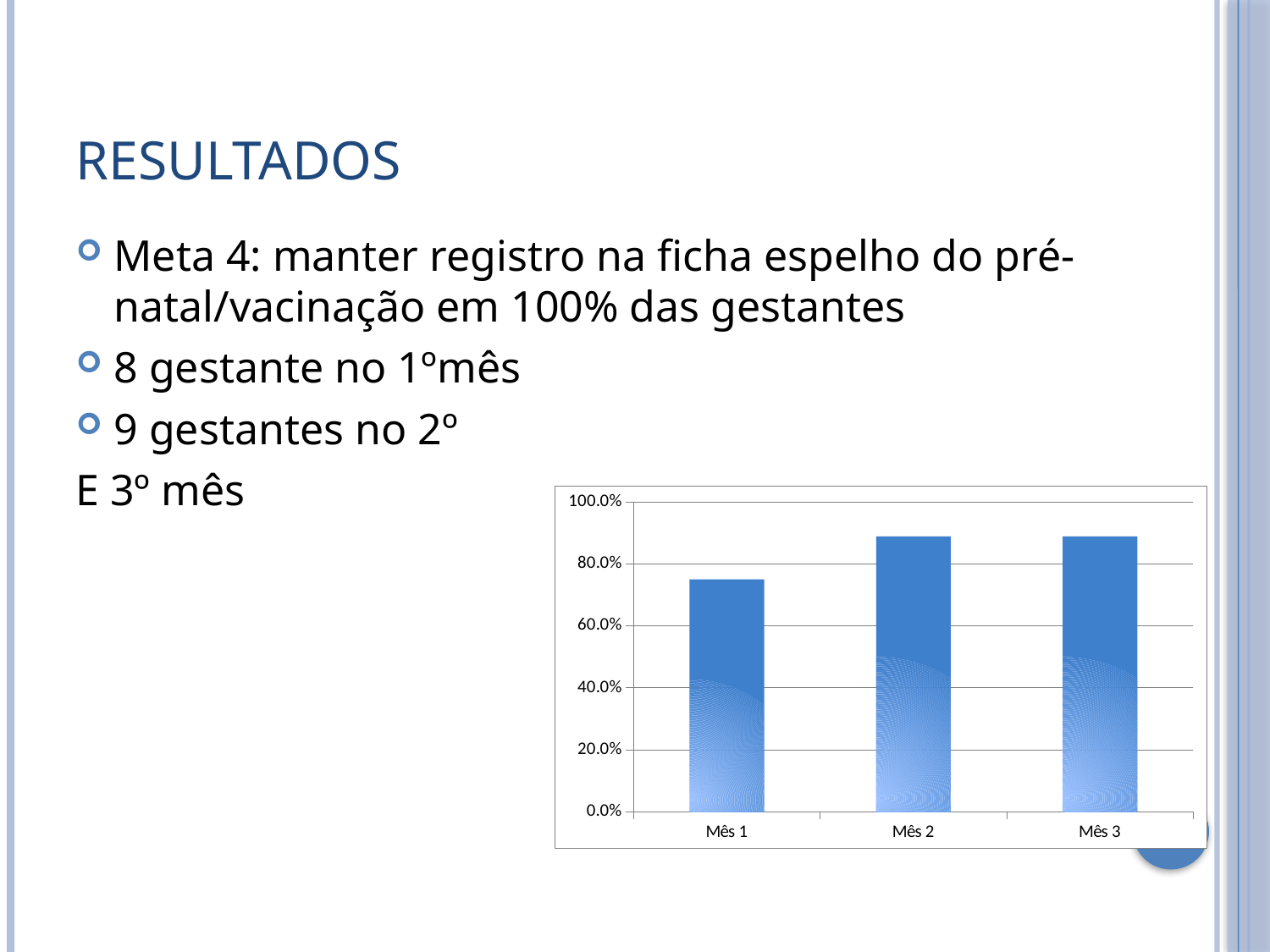
Which category has the lowest bar in the chart? Mês 1 Is the value for Mês 2 greater or less than 80.0%? greater What colour are the bars in the chart? Blue Is the value for Mês 1 greater or less than 60.0%? greater Does the value rise or fall from Mês 1 to Mês 2? rise How many categories are plotted on the x axis of the chart? 3 Is the value for Mês 1 greater or less than 80.0%? less Which is larger, the value for Mês 3 or the value for Mês 1? Mês 3 What kind of chart is shown on the slide? Bar chart Which is larger, the value for Mês 1 or the value for Mês 2? Mês 2 What is the highest tick label shown on the y axis of the chart? 100.0%